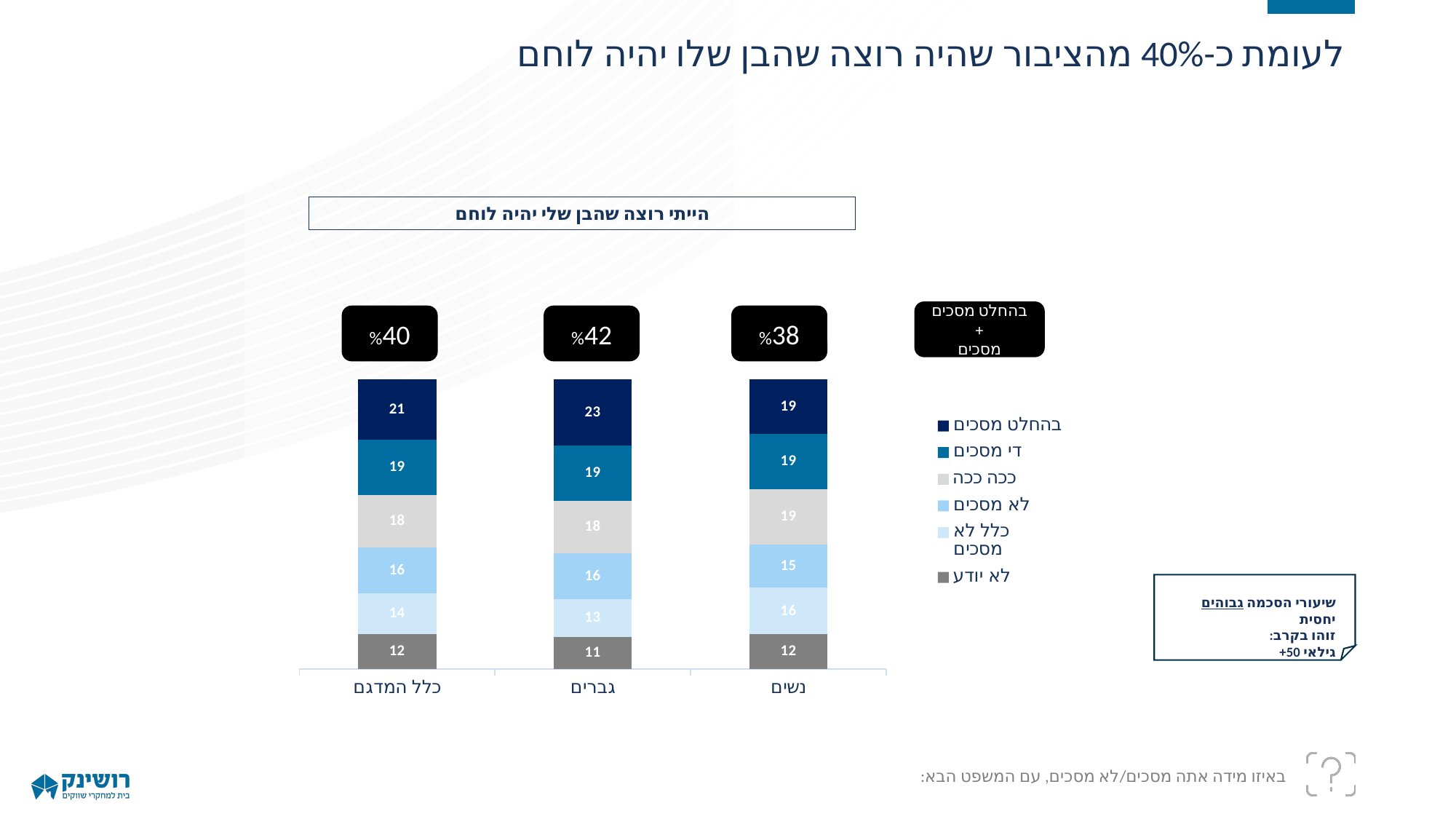
What is the value of the 'בהחלט מסכים' segment for 'גברים'? 23 How many categories are shown along the x axis of the chart? 3 Which category has the lowest 'לא יודע' value? גברים What type of chart is shown on the slide? stacked bar chart What is the value of the 'לא יודע' segment for 'כלל המדגם'? 12 Which is larger: the 'לא מסכים' value for 'כלל המדגם' or for 'נשים'? כלל המדגם What is the value of the 'כלל לא מסכים' segment for 'נשים'? 16 What combined percentage (בהחלט מסכים + מסכים) is shown in the black box above the 'נשים' bar? 38% What is the total of the stacked bar for 'כלל המדגם'? 100 Which category has the highest 'בהחלט מסכים' value? גברים What is the difference between the 'בהחלט מסכים' values for 'גברים' and 'נשים'? 4 How many series does the chart legend list? 6